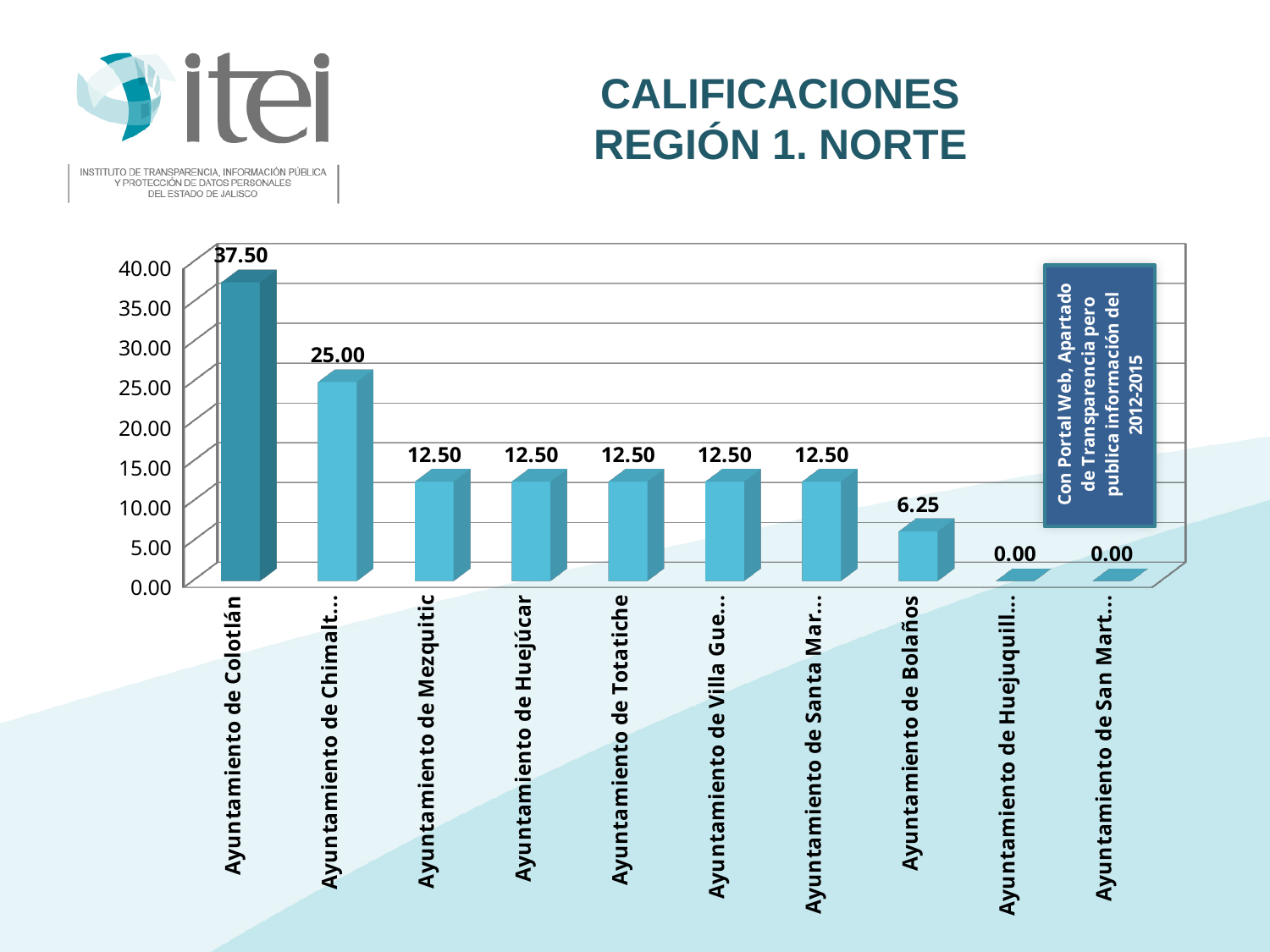
Which is larger, the value for Ayuntamiento de Colotlán or the value for Ayuntamiento de Totatiche? Ayuntamiento de Colotlán What kind of chart is shown on the slide? Bar chart How many categories have a value of 0.00? 2 What is the value for Ayuntamiento de Huejúcar? 12.50 How many categories are shown on the chart? 10 Is the value for Ayuntamiento de Colotlán greater or less than 35.00? greater What is the difference between the values for Ayuntamiento de Totatiche and Ayuntamiento de Bolaños? 6.25 What is the difference between the values for Ayuntamiento de Colotlán and Ayuntamiento de Bolaños? 31.25 What is the value for Ayuntamiento de Bolaños? 6.25 Which category has the highest value? Ayuntamiento de Colotlán What is the value for Ayuntamiento de Mezquitic? 12.50 What is the value for Ayuntamiento de Colotlán? 37.50